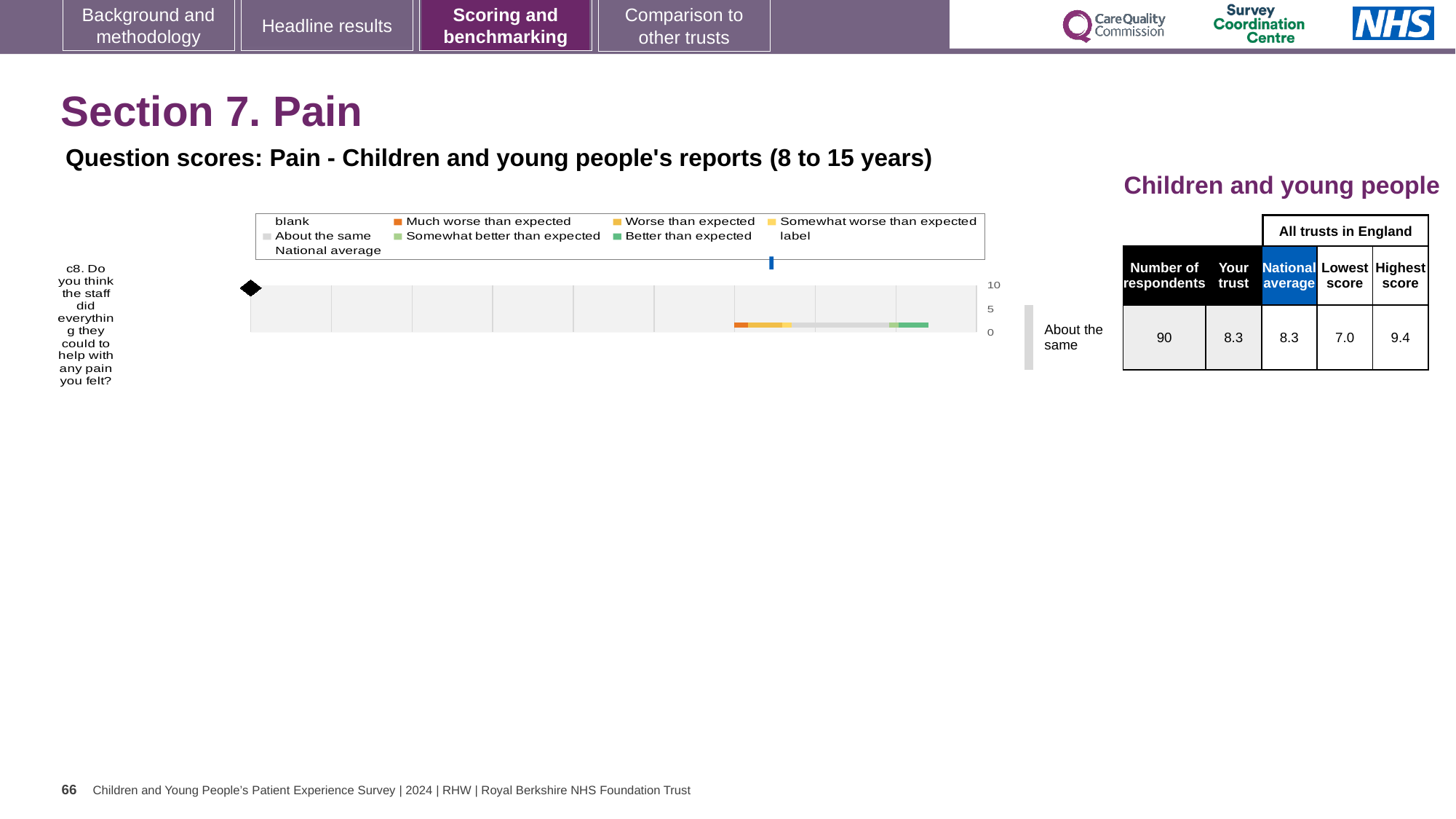
What kind of chart is shown on the slide? bar chart According to the table next to the chart, what is the highest score among all trusts in England for question c8? 9.4 According to the table next to the chart, what is the 'Your trust' score for question c8? 8.3 How many question categories are plotted on the chart? 1 What is the difference between the highest score and the lowest score for question c8 shown in the table? 2.4 According to the table next to the chart, what is the lowest score among all trusts in England for question c8? 7.0 According to the table next to the chart, how many respondents answered question c8? 90 According to the table next to the chart, what is the national average score for question c8? 8.3 How is the trust's result for question c8 categorised relative to expectation? About the same Is the trust's score for question c8 greater or less than 5 on the chart's axis? greater What is the highest value shown on the chart's numeric axis? 10 What colour does the legend use for 'Much worse than expected'? orange